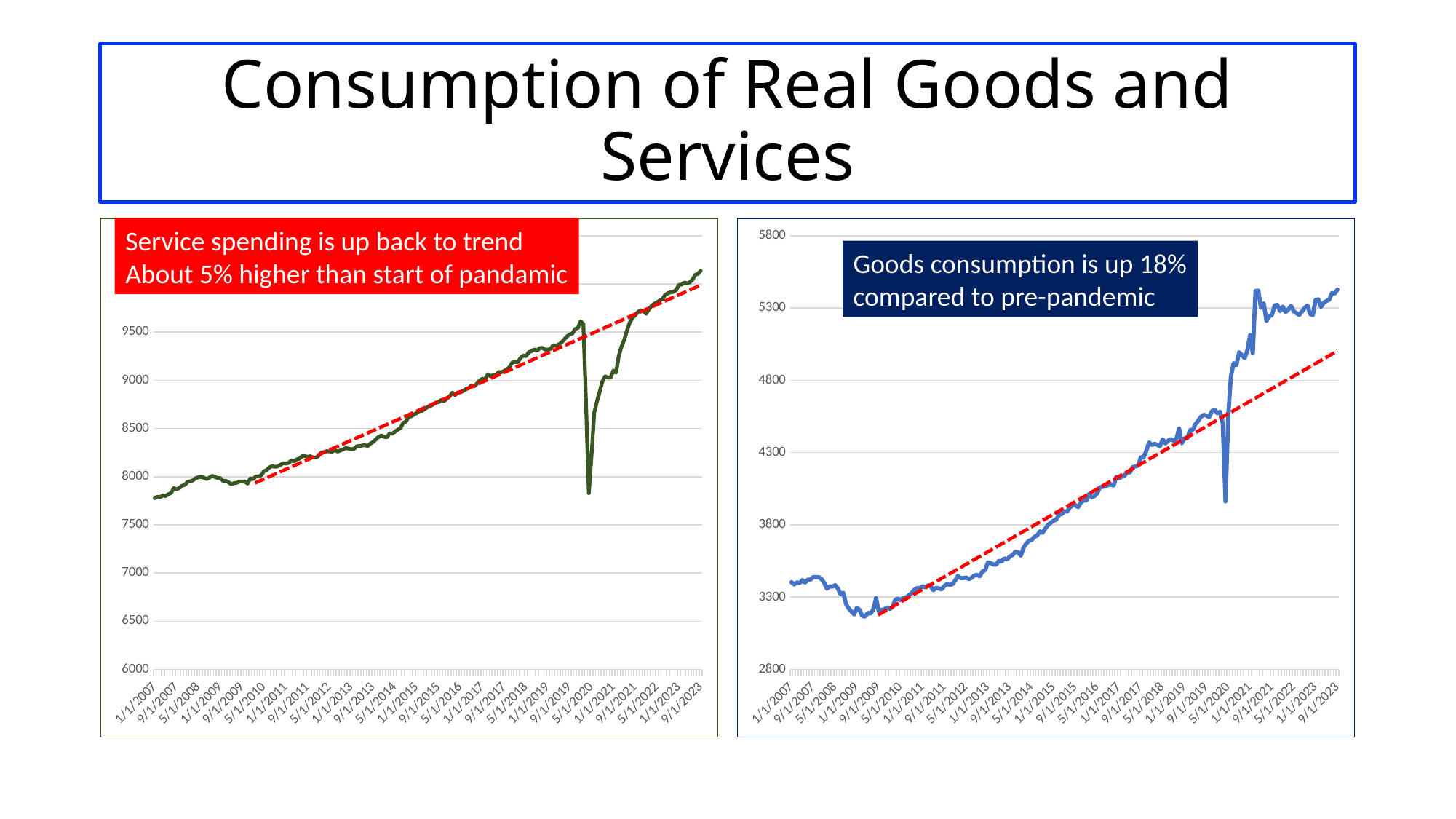
In the left chart, do the values generally rise or fall from 1/1/2007 to 9/1/2023? rise What colour is the data line in the right chart? blue In the right chart, is the value at the bottom of the 2020 dip greater or less than 3800? greater In the right chart, do the values generally rise or fall from 1/1/2007 to 9/1/2023? rise What kind of chart is the left chart on the slide? line chart In the left chart, is the value at 1/1/2007 greater or less than 8000? less What kind of chart is the right chart on the slide? line chart In the left chart, is the value at 9/1/2023 greater or less than 9500? greater According to the annotation on the right chart, by how much is goods consumption up compared to pre-pandemic? 18%